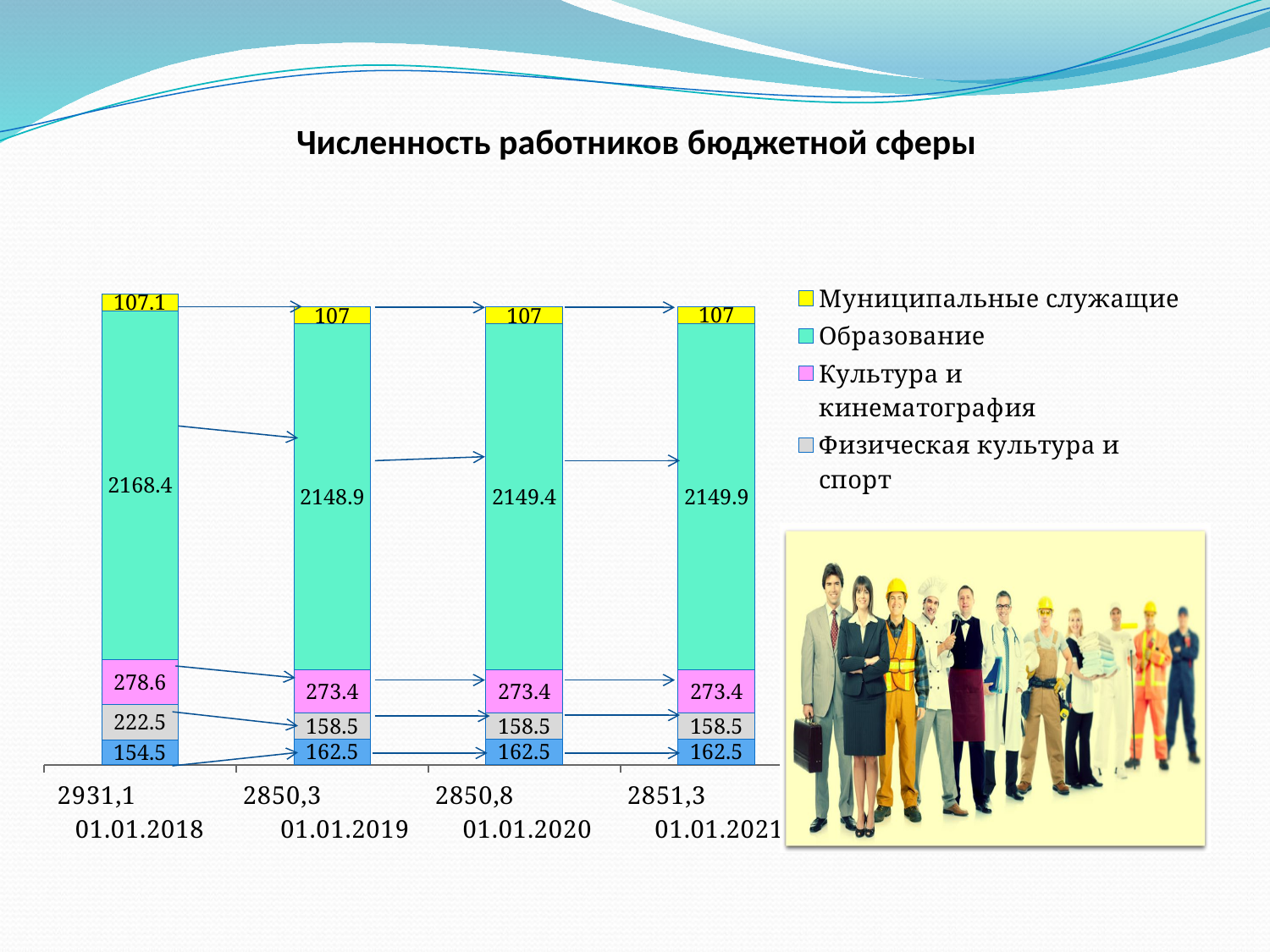
What is the difference between the Образование values on 01.01.2018 and 01.01.2019? 19.5 What is the value for Физическая культура и спорт on 01.01.2018? 222.5 What is the total of the stacked bar for 01.01.2020? 2850,8 What is the value for Муниципальные служащие on 01.01.2021? 107 What is the value for Культура и кинематография on 01.01.2019? 273.4 What is the title of the chart? Численность работников бюджетной сферы Which is larger: Физическая культура и спорт on 01.01.2018 or on 01.01.2021? 01.01.2018 How many series does the legend list? 4 What is the value for Образование on 01.01.2018? 2168.4 On which date is the total number of workers highest? 01.01.2018 What type of chart is shown on the slide? stacked bar chart How many dates (bars) are shown on the x axis? 4